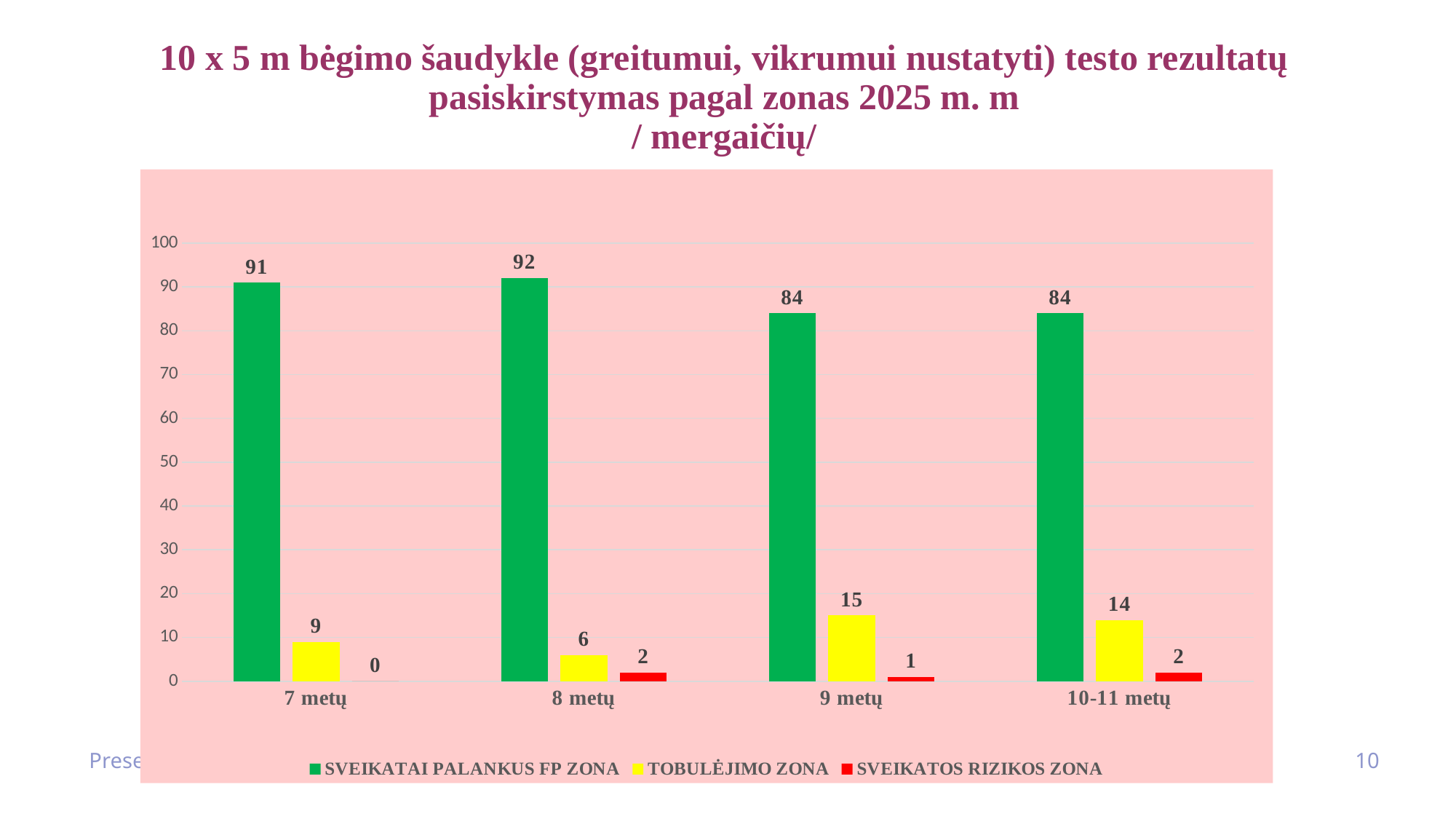
Which age group has the lowest value for TOBULĖJIMO ZONA? 8 metų What is the value for TOBULĖJIMO ZONA for 10-11 metų? 14 What colour are the bars for SVEIKATOS RIZIKOS ZONA? Red What kind of chart is shown on the slide? Bar chart Which is larger: the TOBULĖJIMO ZONA value for 7 metų or for 8 metų? 7 metų How many series does the legend list? 3 What is the value for SVEIKATAI PALANKUS FP ZONA for 8 metų? 92 What is the value for SVEIKATOS RIZIKOS ZONA for 7 metų? 0 How many age groups are shown on the x axis? 4 What is the difference between the SVEIKATAI PALANKUS FP ZONA values for 8 metų and 9 metų? 8 What is the value for TOBULĖJIMO ZONA for 9 metų? 15 Which age group has the highest value for SVEIKATAI PALANKUS FP ZONA? 8 metų